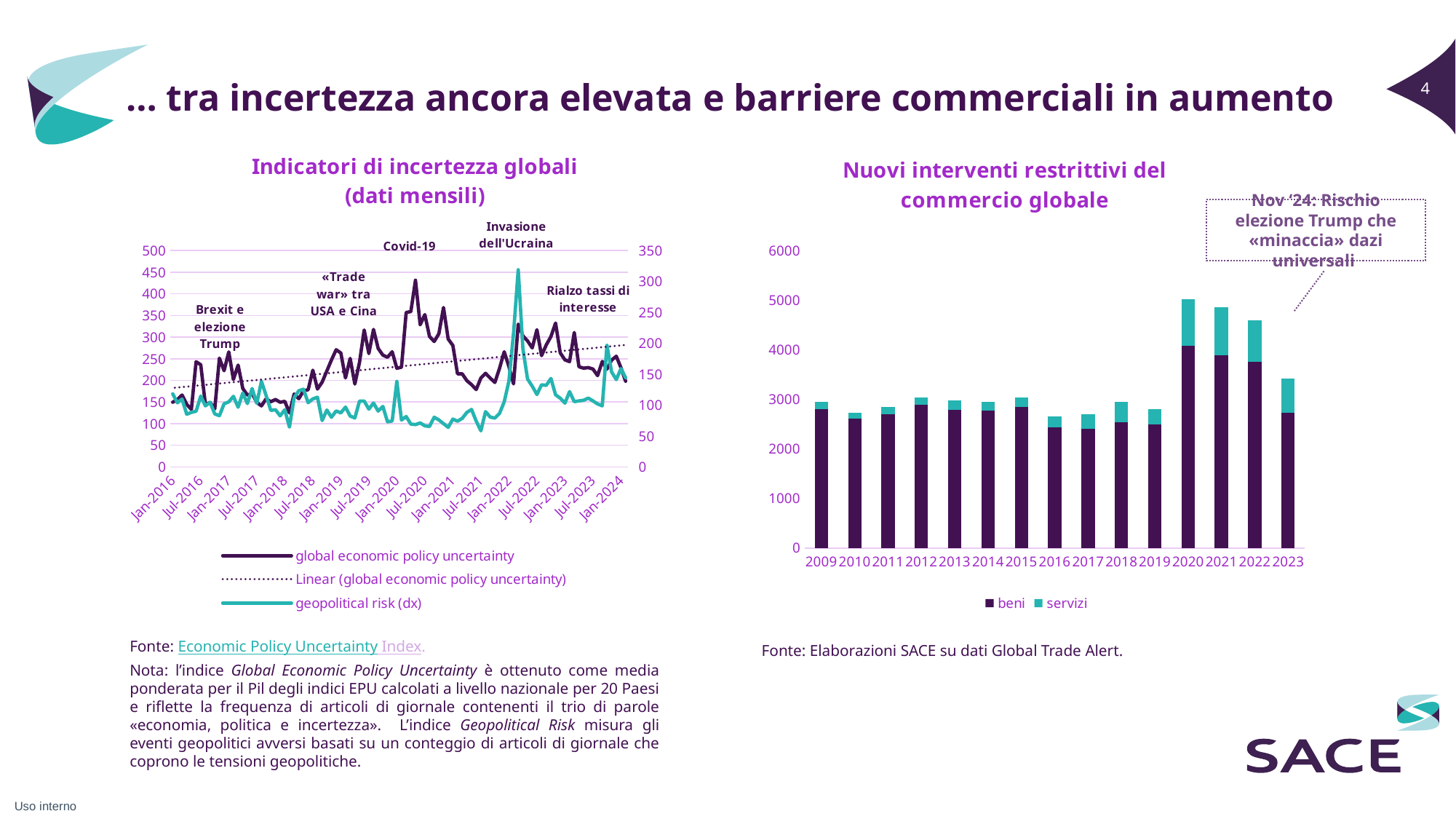
How many entries does the legend of the 'Indicatori di incertezza globali (dati mensili)' chart list? 3 In the 'Nuovi interventi restrittivi del commercio globale' chart, is the 'beni' value for 2021 greater or less than 3000? greater In the 'Nuovi interventi restrittivi del commercio globale' chart, is the total for 2020 greater or less than 4000? greater In the 'Nuovi interventi restrittivi del commercio globale' chart, which year has the larger total bar, 2020 or 2023? 2020 What kind of chart is the 'Indicatori di incertezza globali (dati mensili)' chart? Line chart In the 'Nuovi interventi restrittivi del commercio globale' chart, how many years are shown on the x axis? 15 In the 'Indicatori di incertezza globali (dati mensili)' chart, does the 'Linear (global economic policy uncertainty)' trend line rise or fall from left to right? Rises What kind of chart is the 'Nuovi interventi restrittivi del commercio globale' chart? Stacked bar chart How many series does the legend of the 'Nuovi interventi restrittivi del commercio globale' chart list? 2 In the 'Nuovi interventi restrittivi del commercio globale' chart, which year has the highest total bar? 2020 In the 'Indicatori di incertezza globali (dati mensili)' chart, which series is plotted on the right-hand (dx) axis? geopolitical risk (dx) In the 'Nuovi interventi restrittivi del commercio globale' chart, is the total for 2016 greater or less than 3000? less